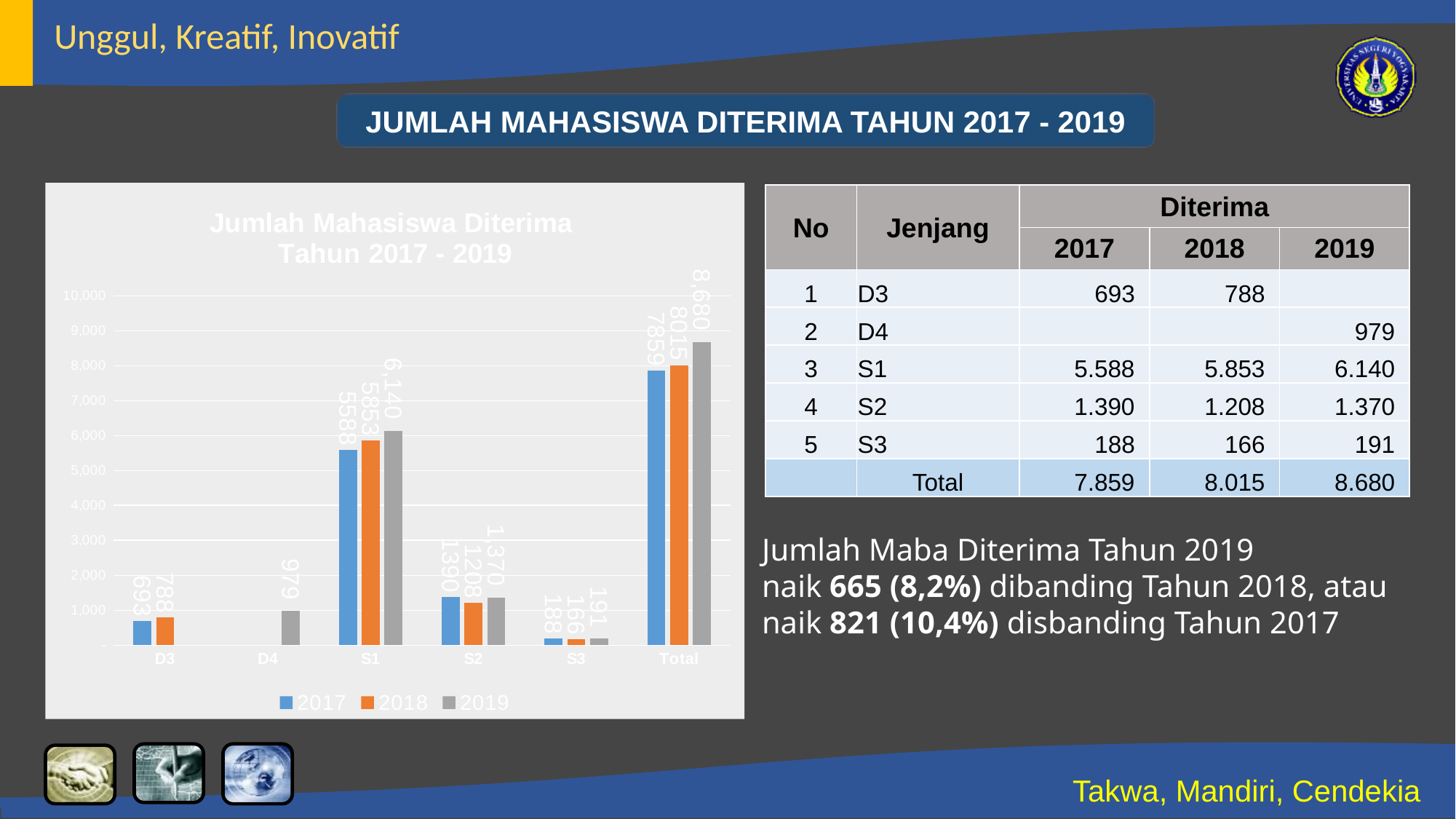
What is the value for S1 in the 2017 series? 5588 What is the value for S3 in the 2018 series? 166 What is the title of the chart? Jumlah Mahasiswa Diterima Tahun 2017 - 2019 Excluding the Total category, which category has the highest value in the 2019 series? S1 Which category has the lowest value in the 2017 series? S3 What is the value for D4 in the 2019 series? 979 Which is larger for S2: the 2017 value or the 2019 value? 2017 What is the difference between the 2019 and 2018 values for S1? 287 What kind of chart is shown? bar chart How many series does the legend list? 3 What is the value for Total in the 2019 series? 8,680 How many categories are shown on the x axis? 6